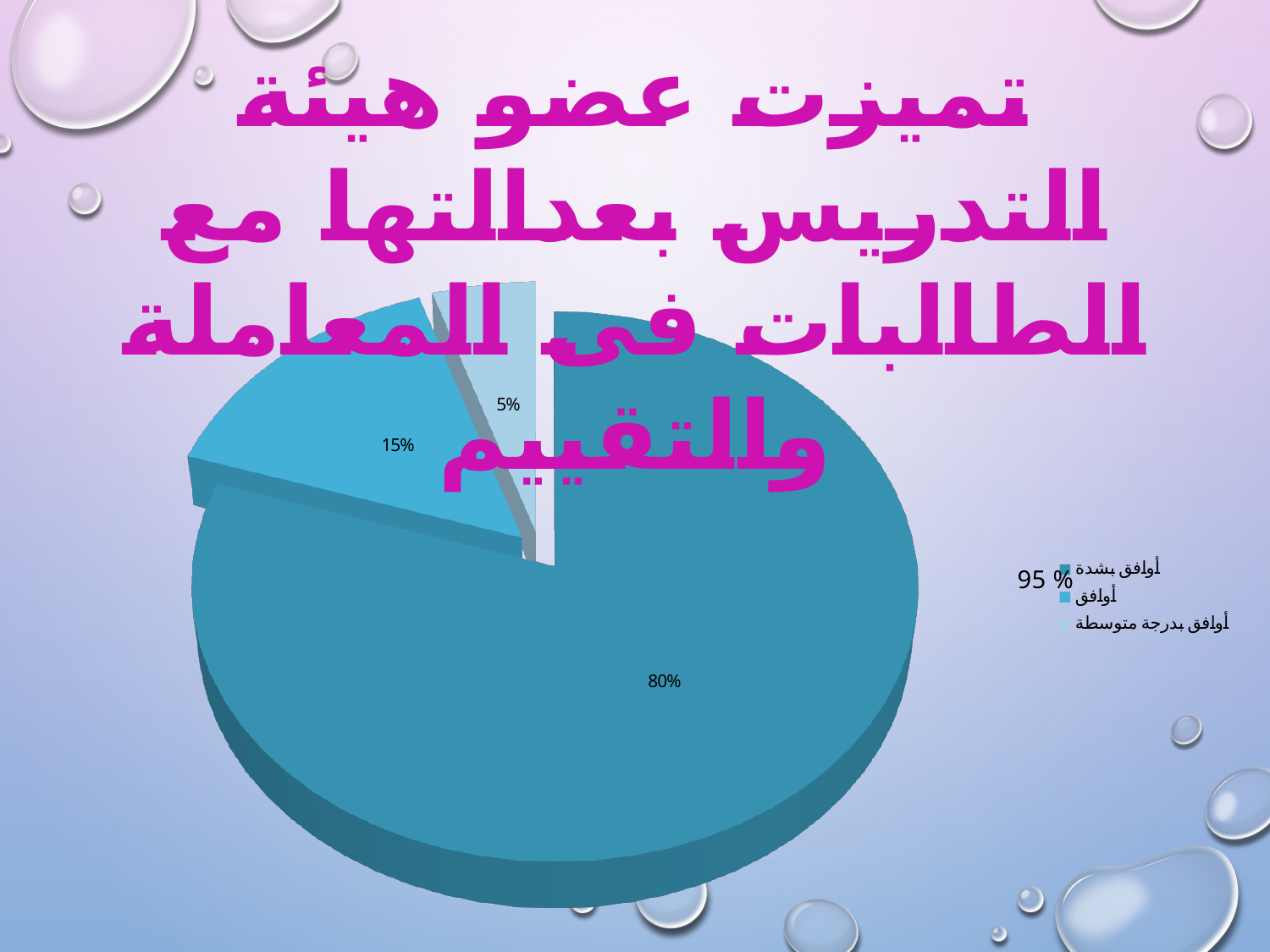
What percentage is shown for the أوافق slice? 15% What percentage is shown for the أوافق بدرجة متوسطة slice? 5% How many slices does the pie chart have? 3 What is the difference in percentage points between the أوافق slice and the أوافق بدرجة متوسطة slice? 10 Which category has the smallest slice of the pie? أوافق بدرجة متوسطة Which slice is larger, أوافق or أوافق بدرجة متوسطة? أوافق Which category has the largest slice of the pie? أوافق بشدة What kind of chart is shown on the slide? pie chart What percentage figure is printed next to the legend? 95 % What percentage of the pie is labelled for the أوافق بشدة slice? 80% What is the difference in percentage points between the أوافق بشدة slice and the أوافق slice? 65 How many entries does the legend list? 3